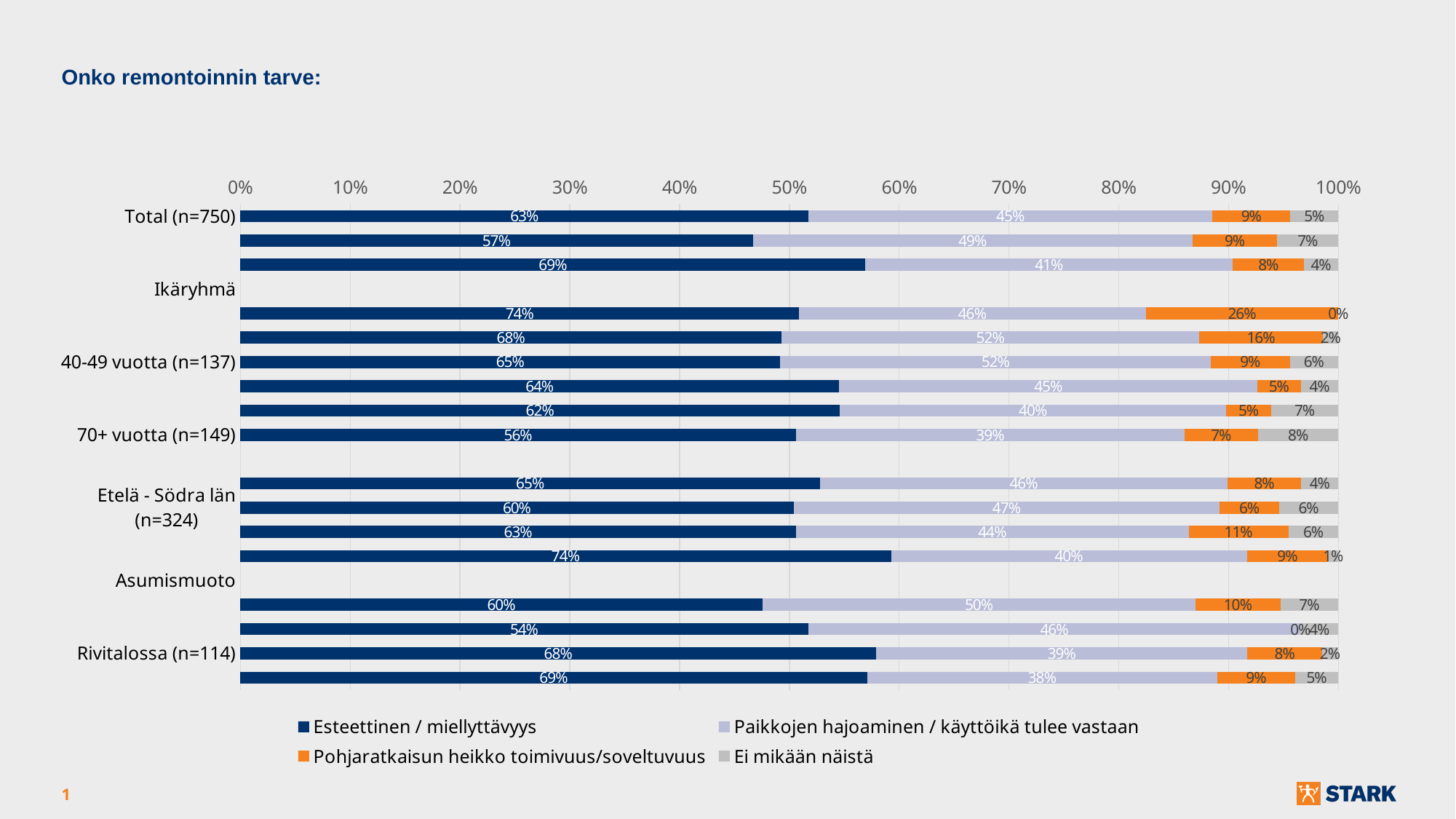
What is the labelled value of 'Esteettinen / miellyttävyys' for Total (n=750)? 63% What is the labelled value of 'Pohjaratkaisun heikko toimivuus/soveltuvuus' for 70+ vuotta (n=149)? 7% What is the labelled value of 'Paikkojen hajoaminen / käyttöikä tulee vastaan' for Total (n=750)? 45% What is the difference between the labelled 'Esteettinen / miellyttävyys' values for Total (n=750) and 70+ vuotta (n=149)? 7 percentage points What kind of chart is shown on the slide? Stacked bar chart Which legend entry is shown in orange? Pohjaratkaisun heikko toimivuus/soveltuvuus What is the labelled value of 'Ei mikään näistä' for 70+ vuotta (n=149)? 8% Which has the larger labelled 'Esteettinen / miellyttävyys' value, Total (n=750) or 70+ vuotta (n=149)? Total (n=750) How many series does the legend list? 4 What is the labelled value of 'Paikkojen hajoaminen / käyttöikä tulee vastaan' for Rivitalossa (n=114)? 39% What is the labelled value of 'Esteettinen / miellyttävyys' for 40-49 vuotta (n=137)? 65% What is the title of the chart? Onko remontoinnin tarve: